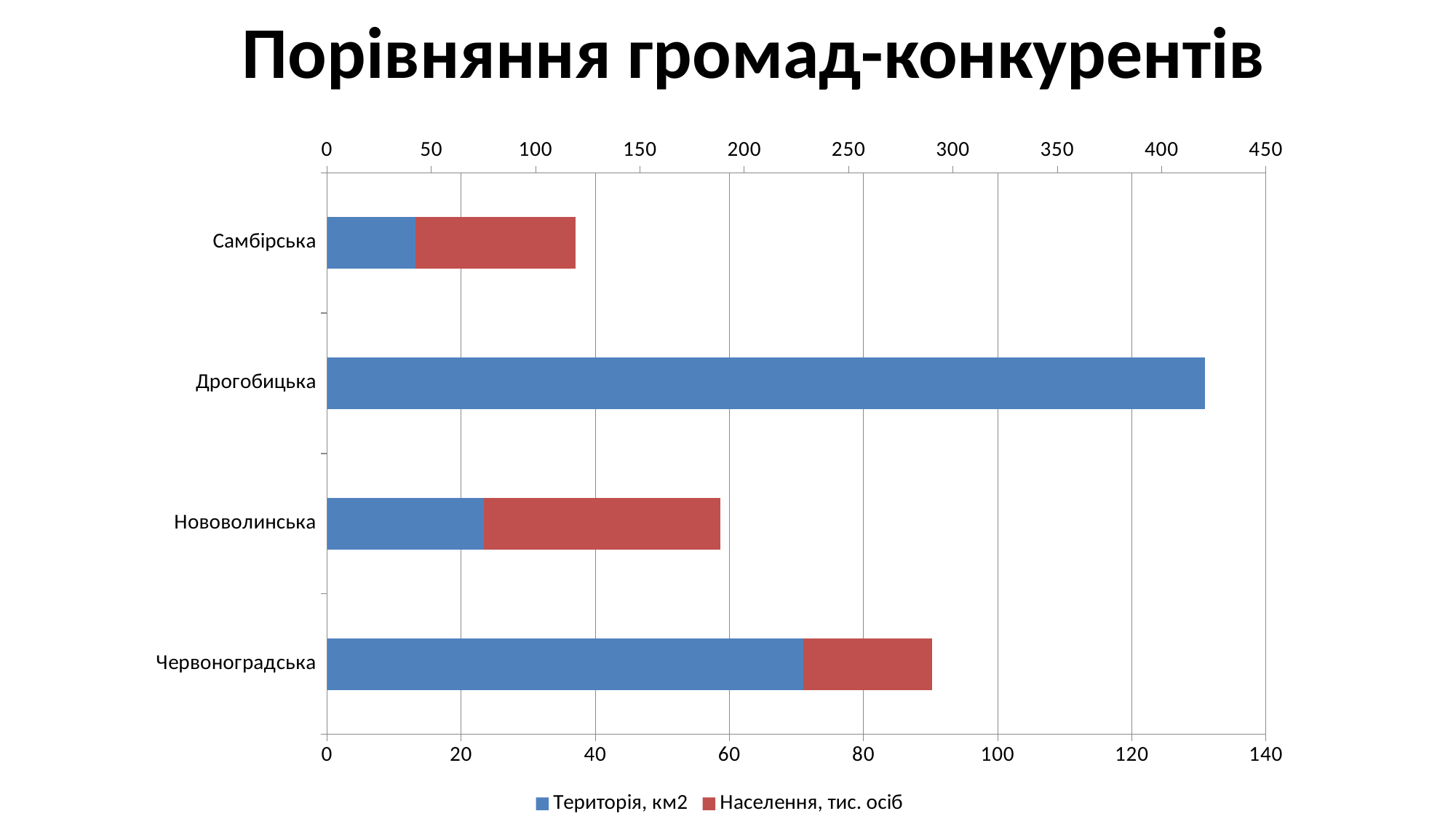
How many series does the legend list? 2 Which has the larger Територія, км2 bar: Дрогобицька or Самбірська? Дрогобицька Which has the larger Територія, км2 bar: Червоноградська or Нововолинська? Червоноградська What kind of chart is shown on the slide? bar chart Which series is shown in red according to the legend? Населення, тис. осіб Which community has the longest bar for Територія, км2? Дрогобицька What is the title of the chart? Порівняння громад-конкурентів Which community has the shortest bar for Територія, км2? Самбірська How many communities (categories) are shown on the chart? 4 Which community shows no visible segment for Населення, тис. осіб? Дрогобицька